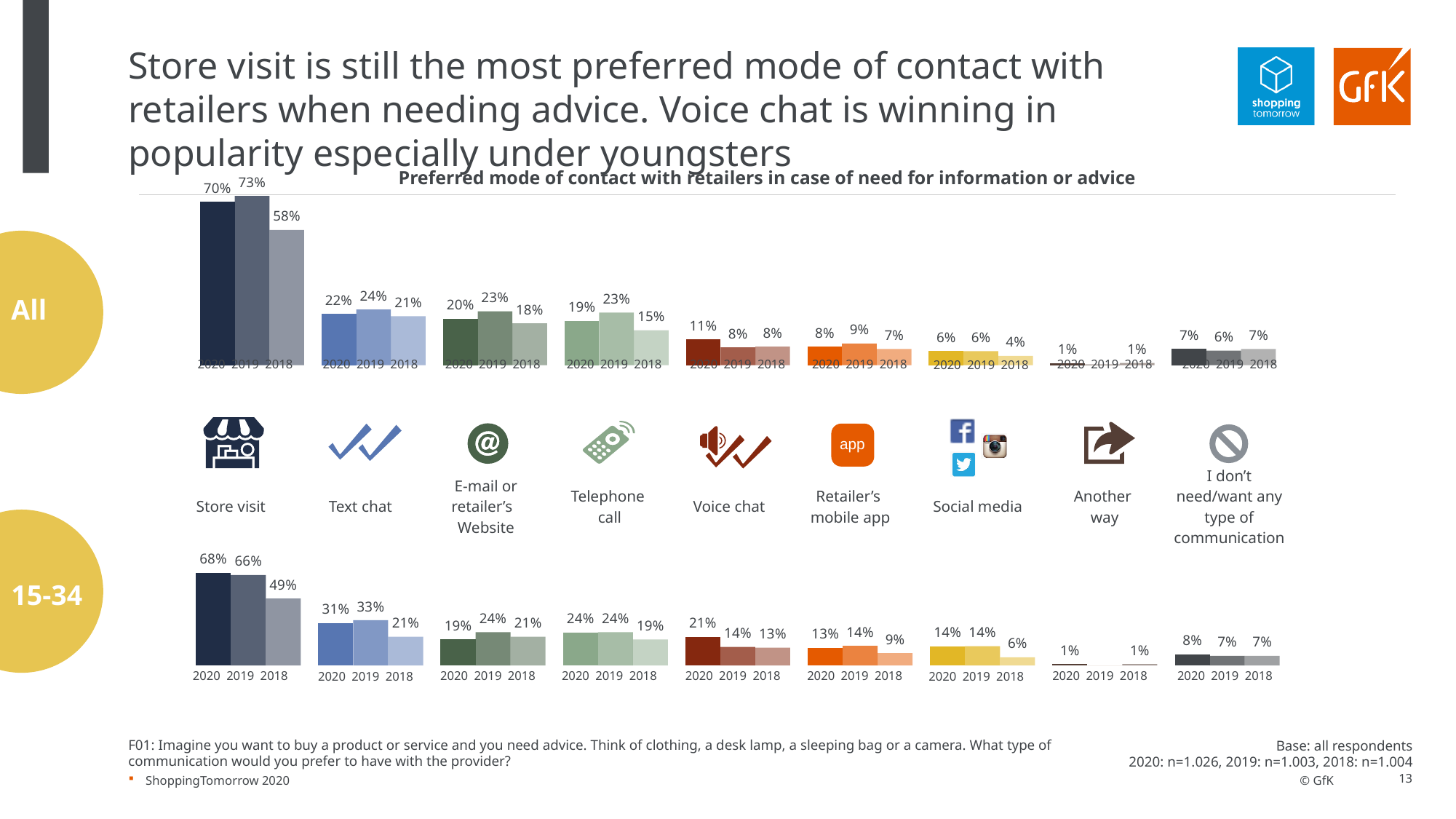
In the '15-34' chart (bottom), which mode of contact has the lowest value in 2020? Another way In the 'All' chart (top), what is the value for Telephone call in 2018? 15% In the 'All' chart (top), which is larger: Voice chat in 2020 or Retailer's mobile app in 2020? Voice chat in 2020 What type of chart is used on this slide? Bar chart In the '15-34' chart (bottom), what is the value for Voice chat in 2020? 21% In the '15-34' chart (bottom), which is larger: Text chat in 2020 or Telephone call in 2020? Text chat in 2020 In the 'All' chart (top), what is the difference between the Store visit values for 2019 and 2018? 15% In the 'All' chart (top), which mode of contact has the highest value in 2019? Store visit In the '15-34' chart (bottom), what is the difference between the Voice chat values for 2020 and 2019? 7% How many modes of contact (categories) are shown in each chart? 9 In the 'All' chart (top), what is the value for Store visit in 2020? 70% In the '15-34' chart (bottom), what is the value for Text chat in 2019? 33%